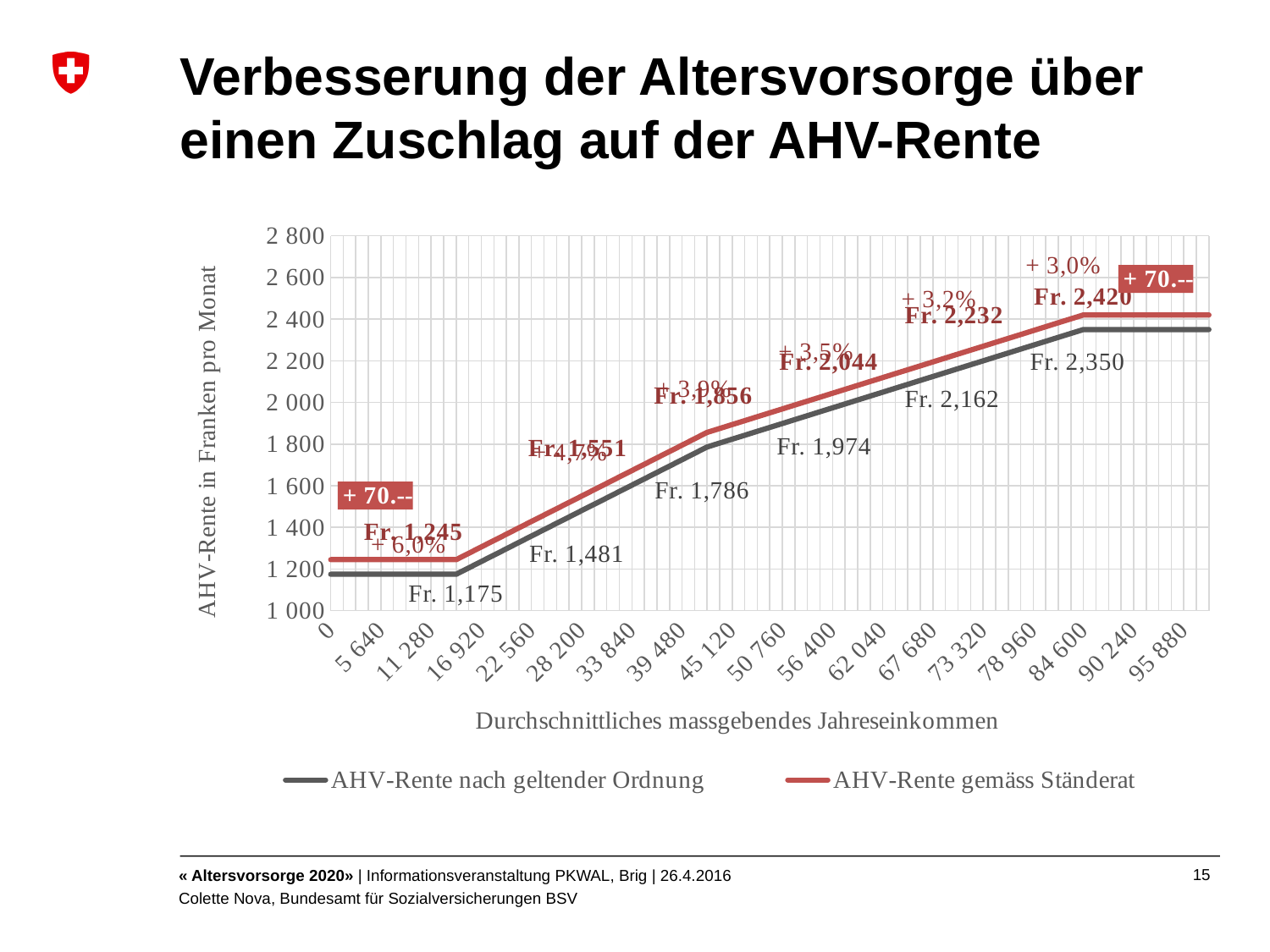
What is the lowest labelled value for the series 'AHV-Rente gemäss Ständerat'? Fr. 1,245 What type of chart is shown on the slide? line chart Do the values of 'AHV-Rente nach geltender Ordnung' rise or fall as the Jahreseinkommen increases along the x axis? rise Which series lies higher across the chart, 'AHV-Rente gemäss Ständerat' or 'AHV-Rente nach geltender Ordnung'? AHV-Rente gemäss Ständerat What is the label of the y axis of the chart? AHV-Rente in Franken pro Monat What is the lowest labelled value for the series 'AHV-Rente nach geltender Ordnung'? Fr. 1,175 What is the highest labelled value for the series 'AHV-Rente gemäss Ständerat'? Fr. 2,420 What is the highest labelled value for the series 'AHV-Rente nach geltender Ordnung'? Fr. 2,350 How many series does the legend list? 2 Is the value of 'AHV-Rente gemäss Ständerat' at a Jahreseinkommen of 0 greater or less than 1 400? less What is the difference between the highest labelled value of 'AHV-Rente gemäss Ständerat' (Fr. 2,420) and the highest labelled value of 'AHV-Rente nach geltender Ordnung' (Fr. 2,350)? Fr. 70 Is the value of 'AHV-Rente nach geltender Ordnung' at a Jahreseinkommen of 95 880 greater or less than 2 200? greater